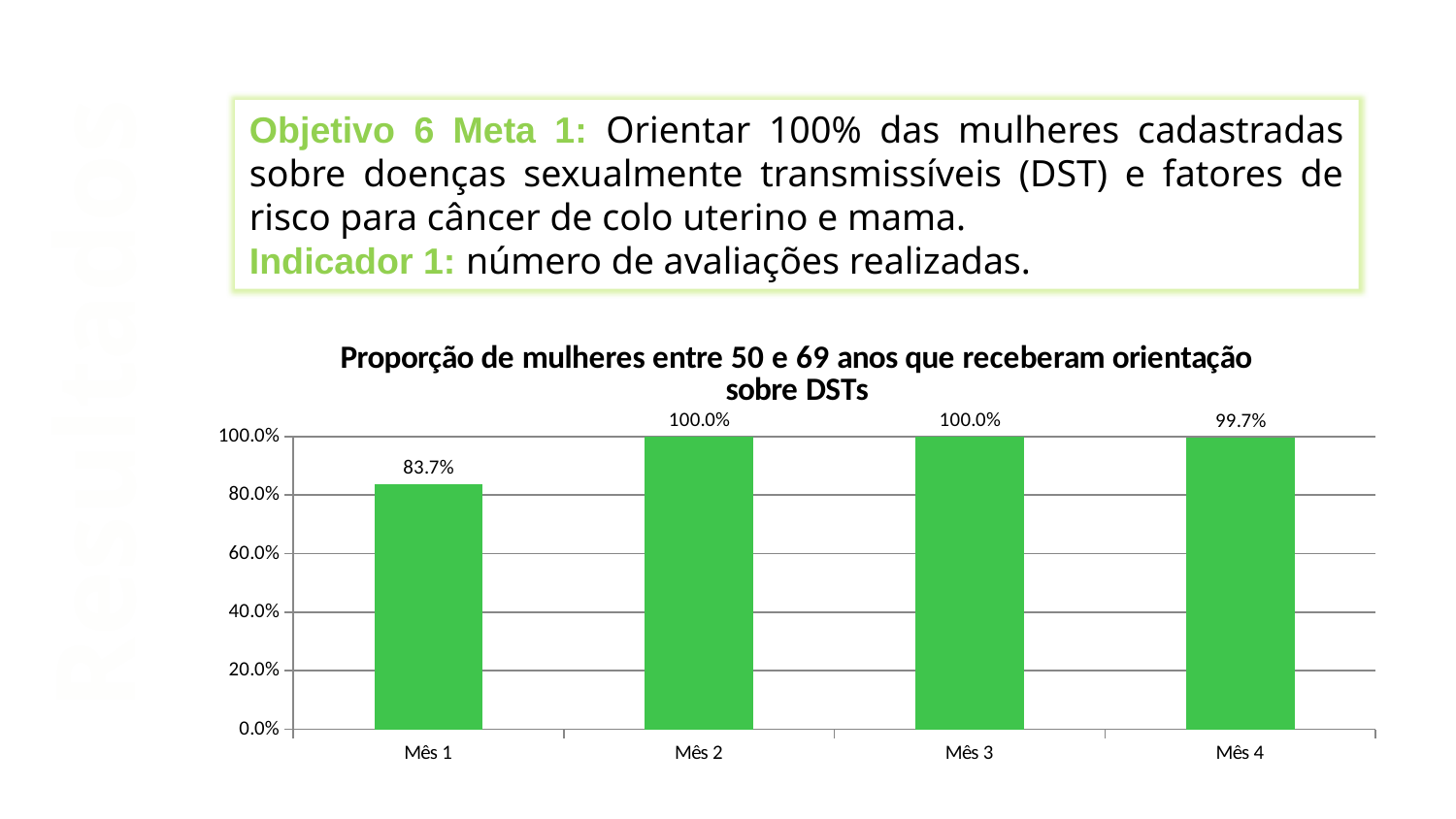
Does the value rise or fall from Mês 1 to Mês 2? rise What is the value for Mês 4? 99.7% What is the value for Mês 2? 100.0% Which is larger, the value for Mês 1 or the value for Mês 4? Mês 4 What is the value for Mês 1? 83.7% What kind of chart is shown on the slide? bar chart Is the value for Mês 1 greater or less than 80.0%? greater What is the title of the chart? Proporção de mulheres entre 50 e 69 anos que receberam orientação sobre DSTs What is the difference between the values for Mês 3 and Mês 4? 0.3% How many months are shown on the x axis? 4 Which month has the lowest value? Mês 1 What is the difference between the values for Mês 2 and Mês 1? 16.3%